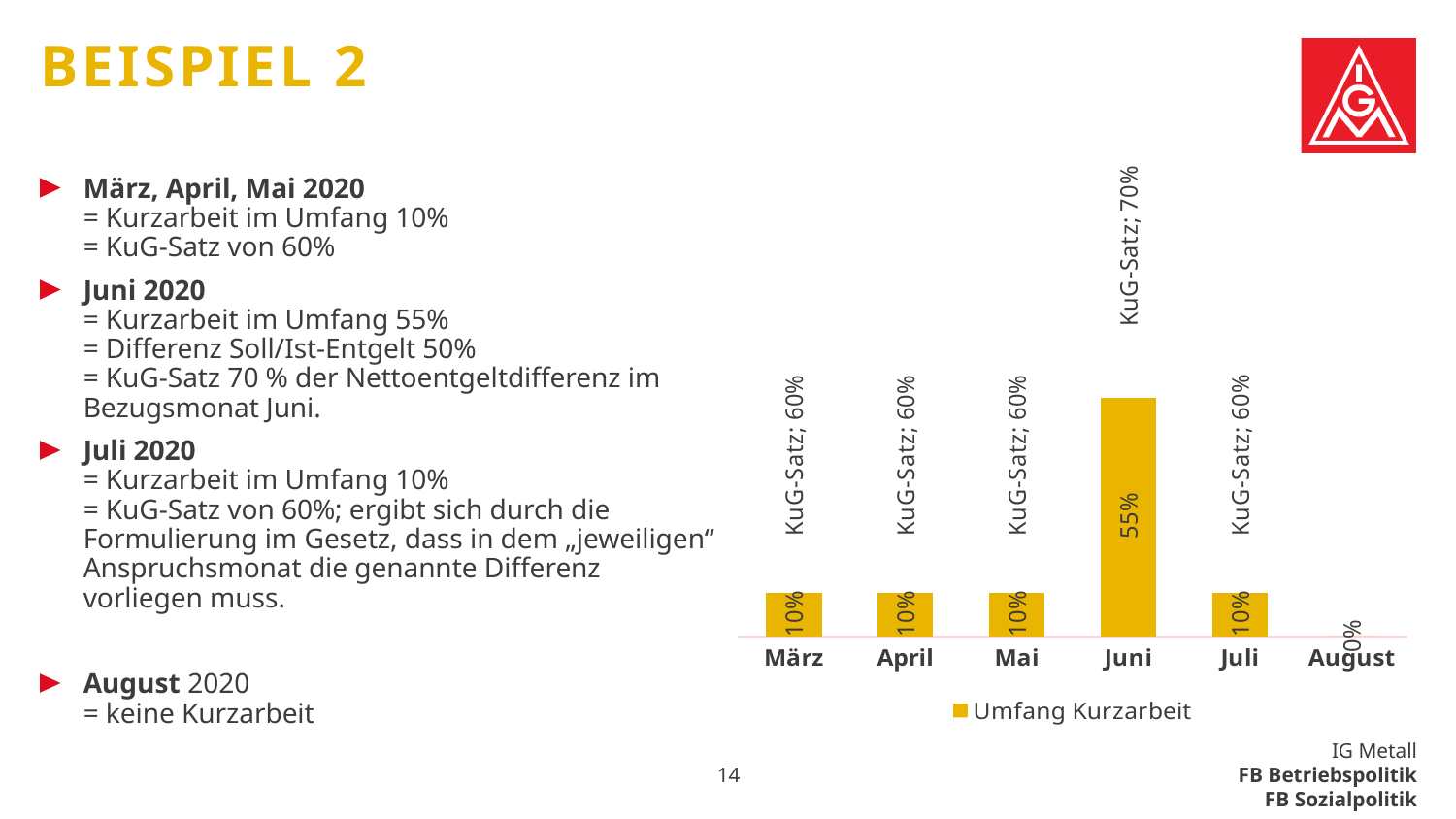
What is the difference between the values for Juni and Juli? 45% Which month has the highest value in the chart? Juni What is the value for Juni in the chart? 55% Which is larger, the value for Juni or the value for Mai? Juni What kind of chart is shown on the slide? bar chart Which month has the lowest value in the chart? August How many series does the chart legend list? 1 What is the value for März in the chart? 10% What KuG-Satz is labelled above the Juni bar? KuG-Satz; 70% What is the value for August in the chart? 0% What is the legend entry of the chart? Umfang Kurzarbeit How many months are shown on the x axis of the chart? 6